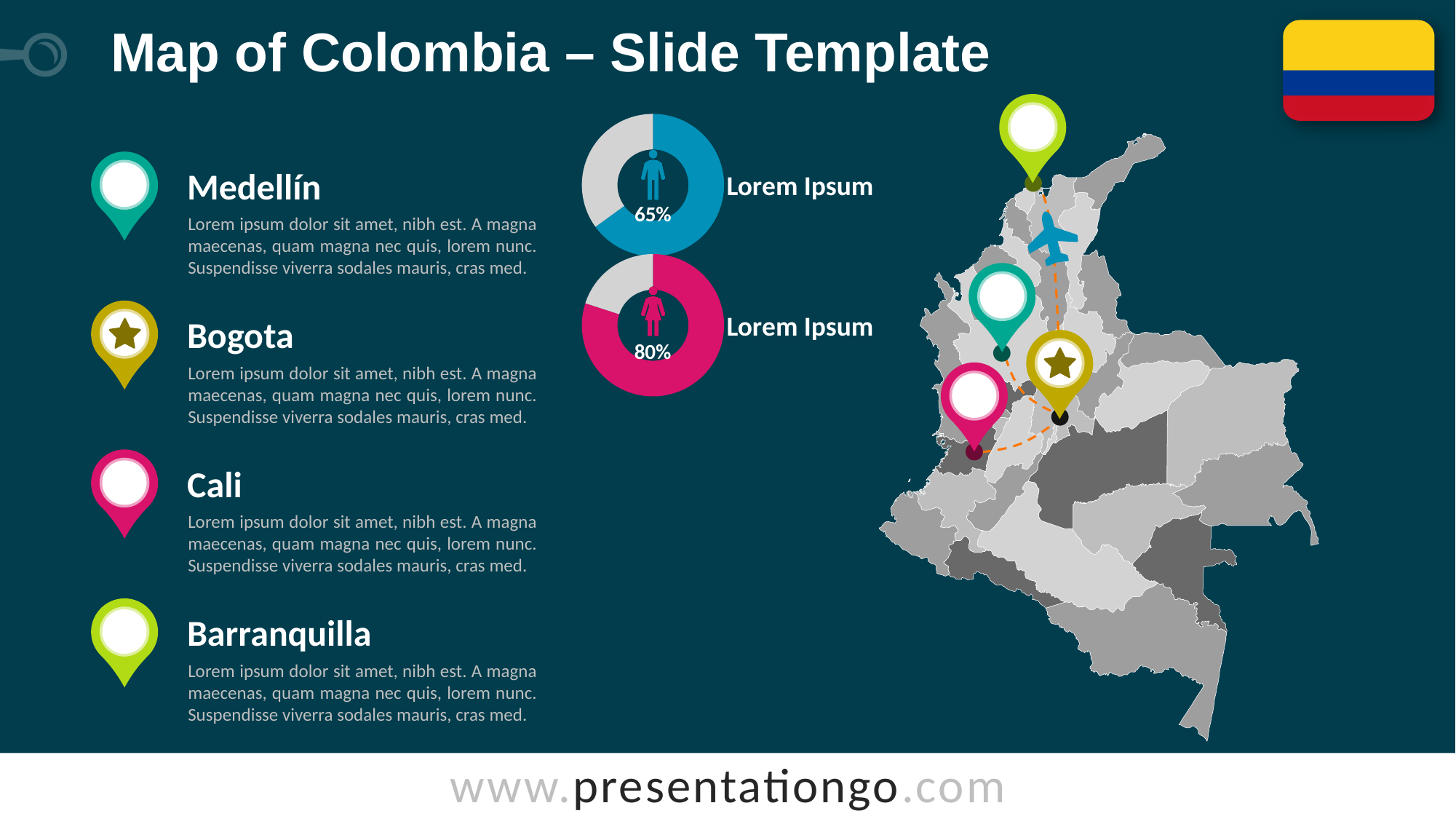
What percentage is shown in the bottom donut chart with the female icon? 80% Is the value in the bottom donut chart with the female icon greater or less than 75%? greater How many donut charts are shown on the slide? 2 Which donut chart shows the lowest percentage? the top one with the male icon (65%) Is the value in the top donut chart with the male icon greater or less than 50%? greater What percentage is shown in the top donut chart with the male icon? 65% What colour is the filled portion of the top donut chart showing 65%? blue What is the difference between the percentage in the bottom donut chart (80%) and the top donut chart (65%)? 15% What kind of chart is used to display the 65% and 80% values? donut chart Which donut chart shows the higher percentage, the top one with the male icon or the bottom one with the female icon? the bottom one with the female icon What colour is the filled portion of the bottom donut chart showing 80%? pink